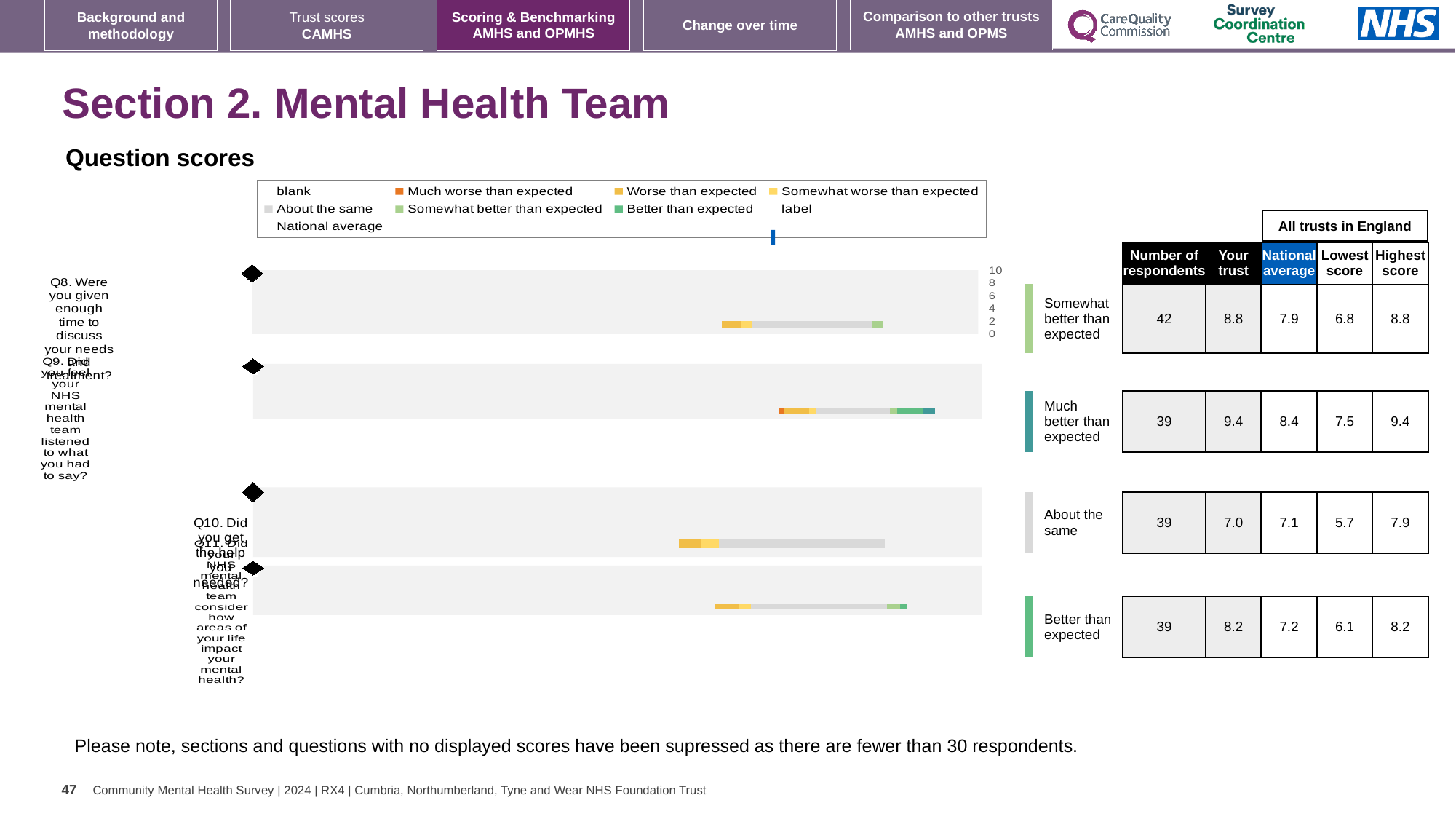
What is the heading above the chart? Question scores How many question bars (Q8 to Q11) are plotted in the 'Question scores' chart? 4 In the table beside the chart, what is the highest score in the row labelled 'Better than expected'? 8.2 In the table beside the chart, what is the national average in the row labelled 'About the same'? 7.1 In the table beside the chart, in the 'Somewhat better than expected' row, which is larger: 'Your trust' or the national average? Your trust In the table beside the chart, what is the difference between 'Your trust' and the national average in the 'Much better than expected' row? 1.0 What colour is the 'National average' marker in the chart legend? blue In the table beside the chart, which row has the lowest 'Your trust' score? About the same In the table beside the chart, which row has the highest 'Your trust' score? Much better than expected In the table beside the chart, what is the 'Your trust' score in the row labelled 'Much better than expected'? 9.4 What kind of chart is shown under the heading 'Question scores'? bar chart In the table beside the chart, how many respondents are listed in the row labelled 'Somewhat better than expected'? 42